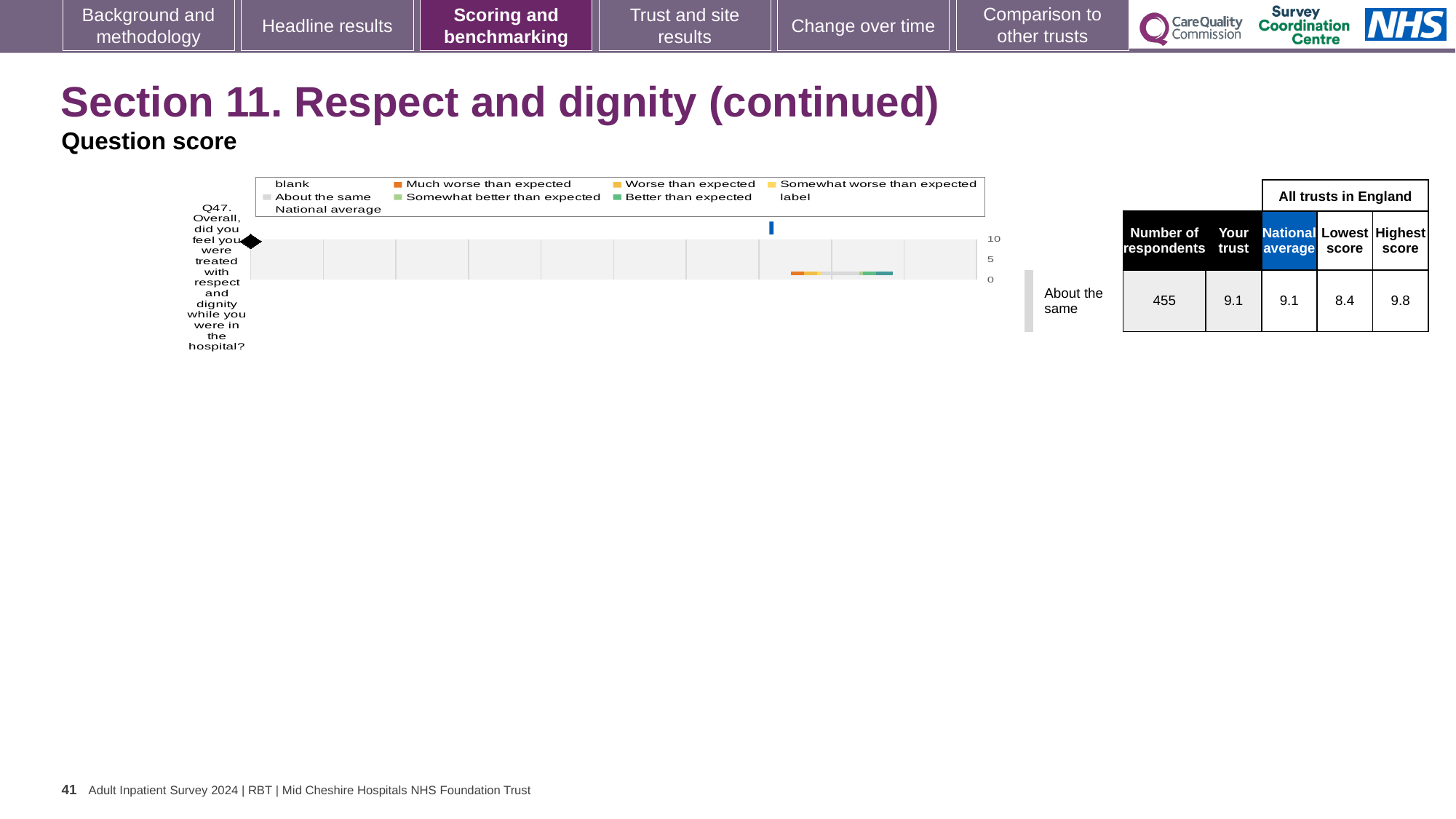
Which is larger for Q47: the trust's score or the lowest score among all trusts in England? the trust's score Which legend entry is shown with the orange colour in the chart? Much worse than expected What benchmark category label is shown for the trust's result on Q47? About the same Is the trust's score for Q47 greater or less than 5 on the chart's axis? greater What is the highest score among all trusts in England for Q47? 9.8 What is the lowest score among all trusts in England for Q47? 8.4 How many questions (categories) are plotted in the chart? 1 What is the difference between the highest score and the lowest score for Q47? 1.4 What kind of chart is shown for Q47 on this slide? bar chart What is the 'Your trust' score for Q47 shown in the table beside the chart? 9.1 What is the national average score for Q47 shown in the table beside the chart? 9.1 How many respondents answered Q47 according to the table beside the chart? 455